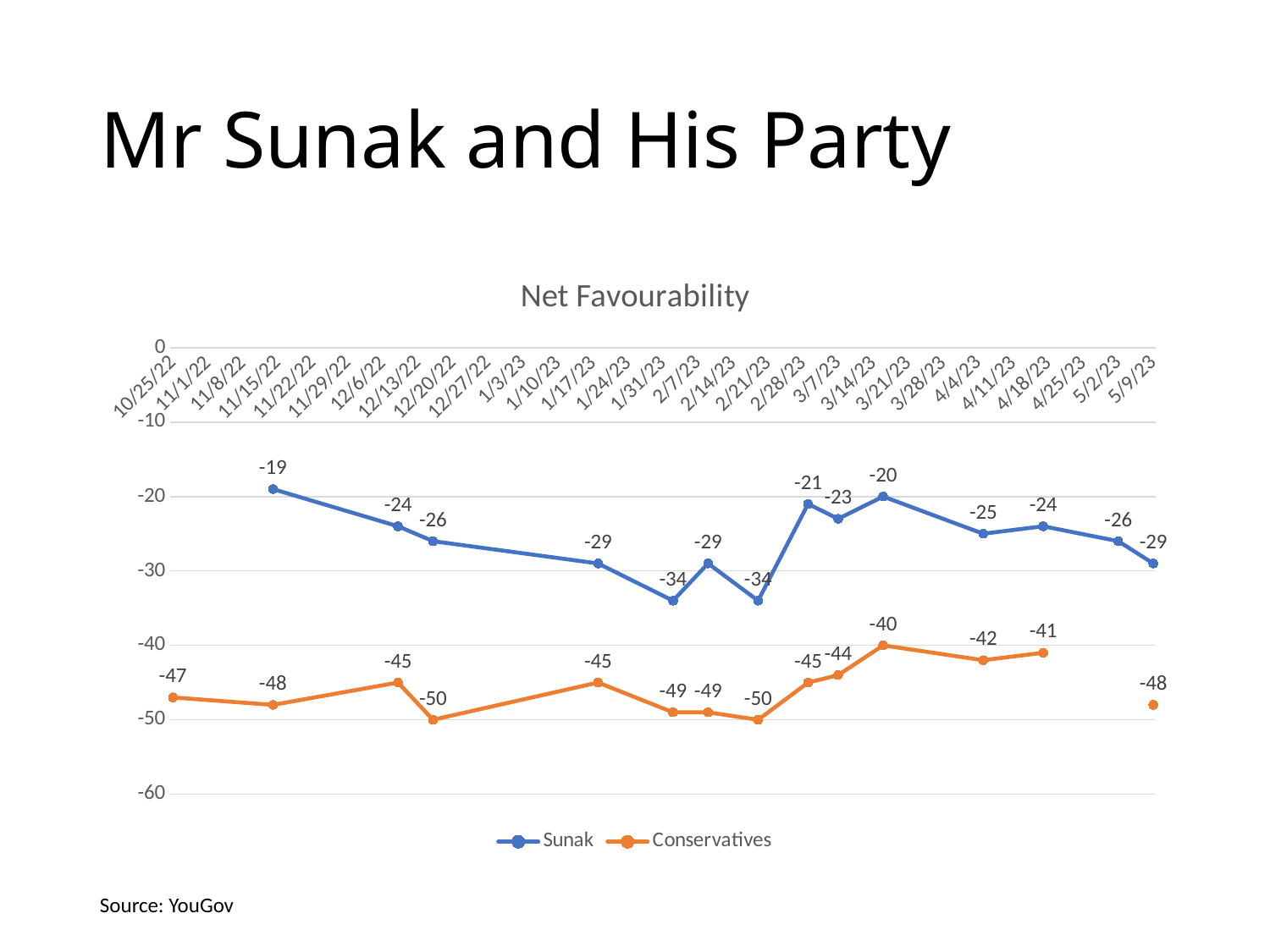
What is the title of the chart? Net Favourability What kind of chart is shown on the slide? line chart What is the highest value plotted for the Conservatives series? -40 What is the lowest value plotted for the Conservatives series? -50 What is the Conservatives net favourability value on 10/25/22? -47 What is the Sunak net favourability value on 5/9/23? -29 What are the two series named in the legend of the chart? Sunak and Conservatives What is the highest value plotted for the Sunak series? -19 What is the Conservatives net favourability value on 5/9/23? -48 What is the lowest value plotted for the Sunak series? -34 How many series does the legend of the Net Favourability chart list? 2 What is the difference between the Sunak and Conservatives values on 5/9/23? 19